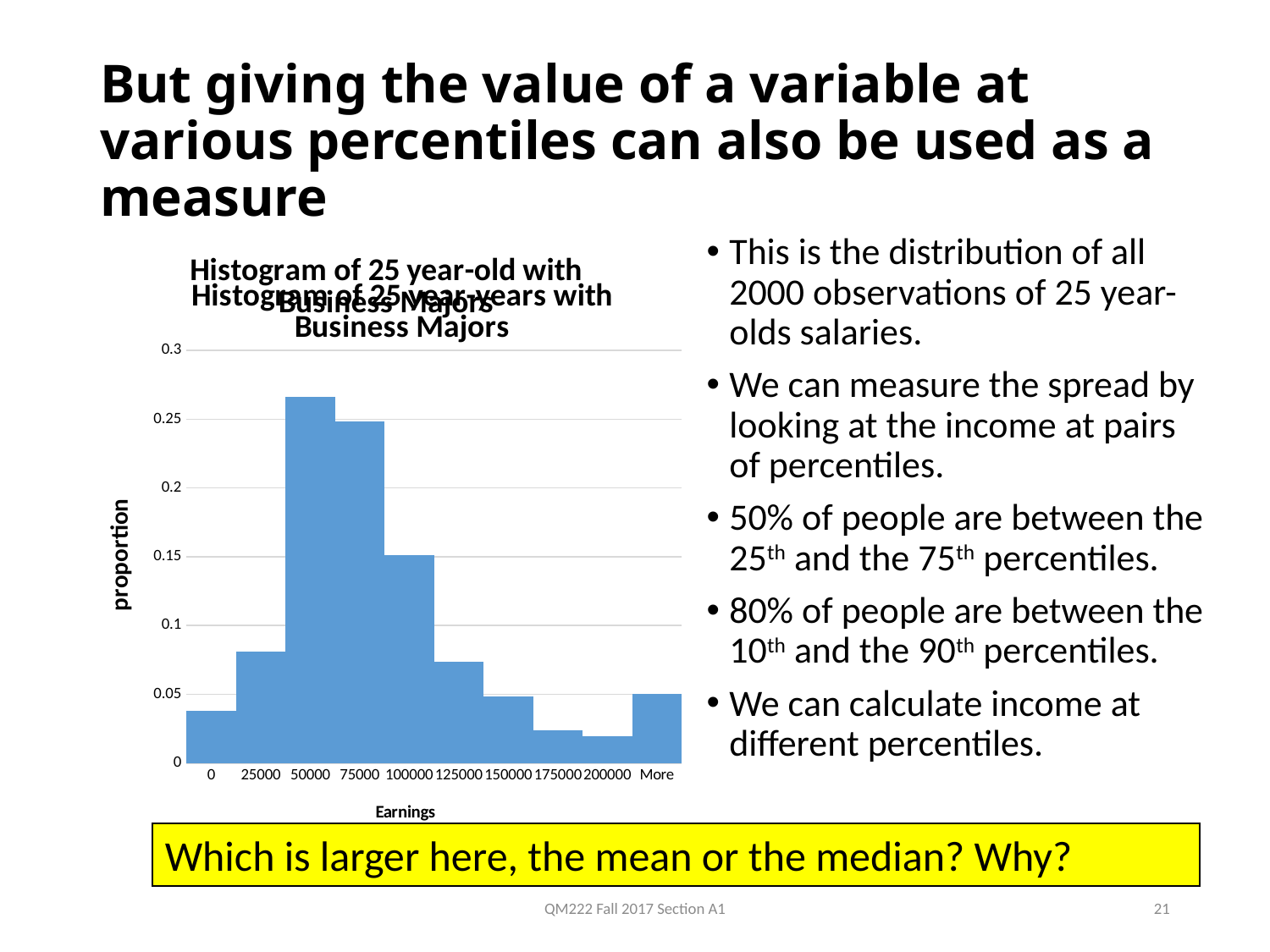
Is the proportion for the 50000 bin greater or less than 0.25? greater Is the proportion for the 25000 bin greater or less than 0.1? less Which earnings bin has the highest proportion? 50000 Do the proportions rise or fall moving from the 50000 bin to the 200000 bin? fall Is the proportion for the 100000 bin greater or less than 0.1? greater Which bin has the larger proportion, 0 or 25000? 25000 What kind of chart is shown on the slide? bar chart (histogram) What is the label on the vertical axis of the histogram? proportion How many bars (earnings bins) are plotted in the histogram? 10 Which bin has the larger proportion, 100000 or 125000? 100000